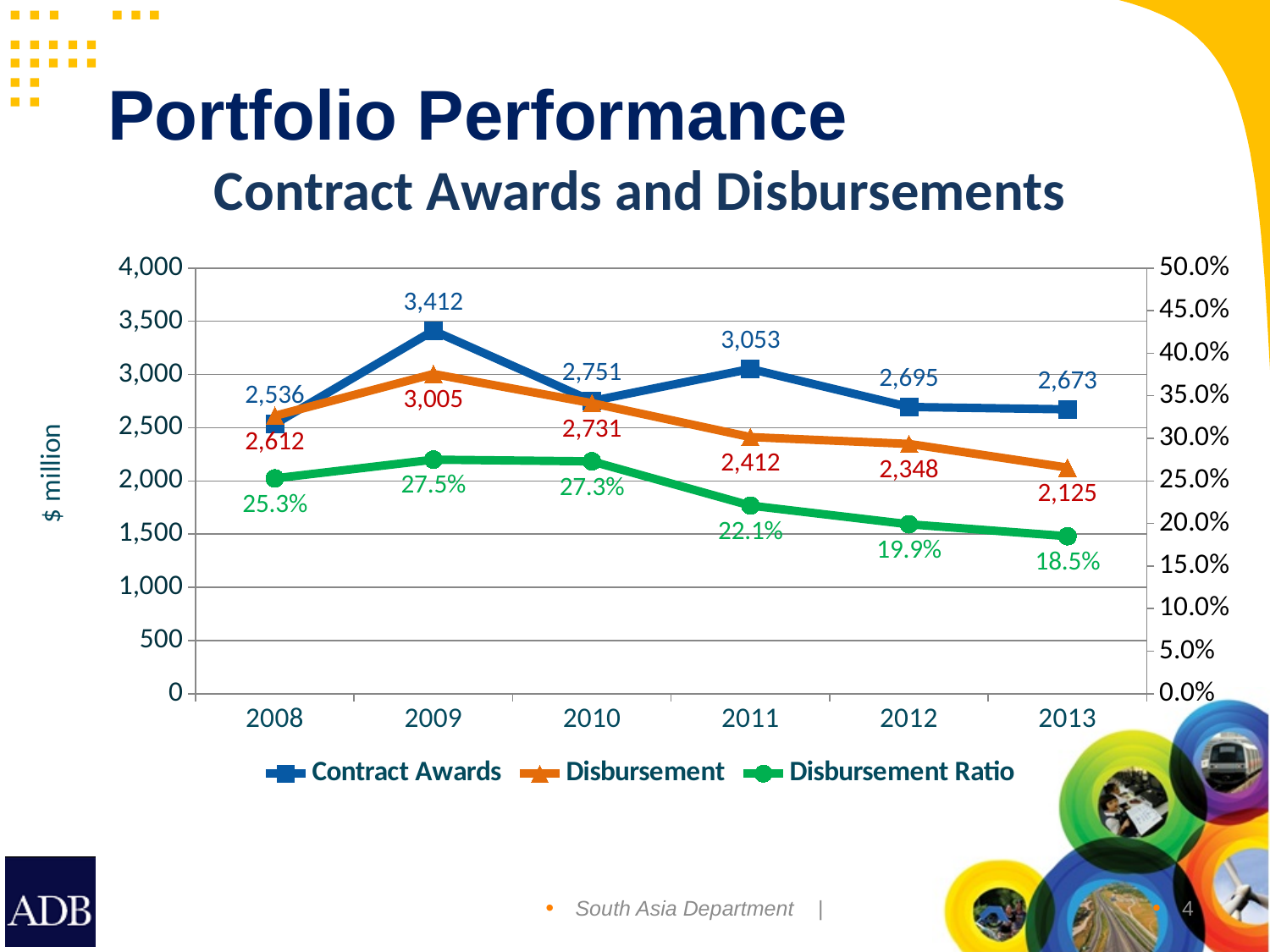
What was the Disbursement Ratio in 2011? 22.1% In which year were Contract Awards highest? 2009 Which was larger in 2008, Contract Awards or Disbursement? Disbursement How many years are shown on the x axis? 6 In which year was the Disbursement Ratio lowest? 2013 How many series does the legend list? 3 Did the Disbursement Ratio rise or fall from 2010 to 2013? Fall What was the Disbursement value in 2013? 2,125 What is the difference between Contract Awards and Disbursement in 2011? 641 What is the label on the left vertical axis? $ million What was the value of Contract Awards in 2009? 3,412 What kind of chart is shown? Line chart